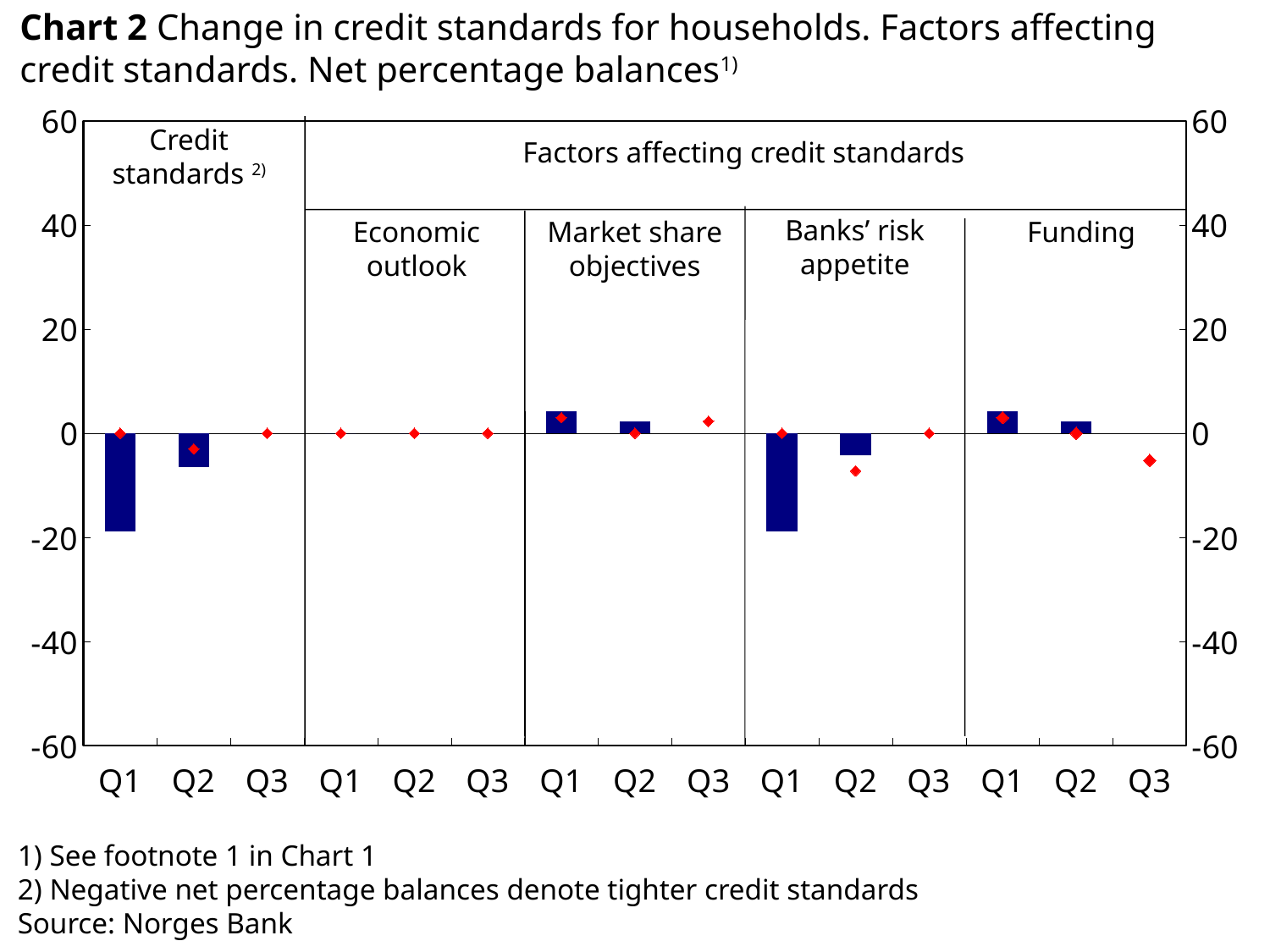
In the Credit standards panel, which quarter has the lowest bar? Q1 Is the bar for Q1 in the Market share objectives panel greater or less than 20? less Is the bar for Q1 in the Credit standards panel greater or less than -10? less How many quarters are shown in each panel of the chart? 3 Is the bar for Q1 in the Banks' risk appetite panel greater or less than -10? less What is the name of the rightmost panel in the chart? Funding How many factors affecting credit standards are shown as separate panels in the chart? 4 What kind of chart is shown on the slide? Combination bar and line chart (bars with red diamond markers) In the Market share objectives panel, is the bar for Q1 or Q2 higher? Q1 In the Credit standards panel, is the bar for Q1 or Q2 lower? Q1 What is the highest value shown on the vertical axis of the chart? 60 Do the bars in the Credit standards panel rise or fall from Q1 to Q3? Rise